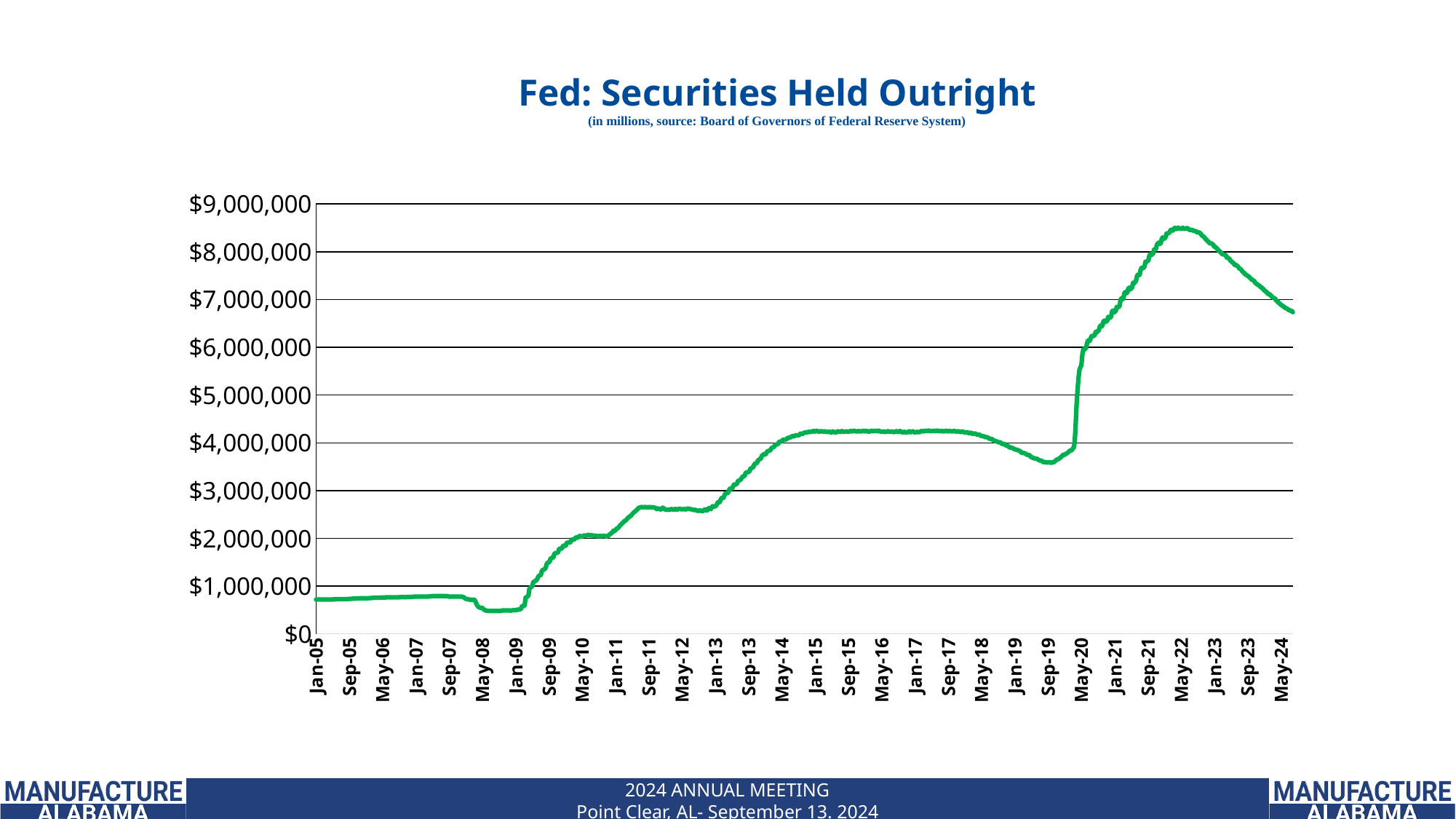
Is the value at Jan-15 greater or less than $4,000,000? greater Is the value at Sep-19 greater or less than $4,000,000? less According to the subtitle, what is the source of the data? Board of Governors of Federal Reserve System What is the title of the chart? Fed: Securities Held Outright How many lines are plotted on the chart? 1 Around which x-axis date does the line reach its highest point? May-22 Does the line rise or fall between May-22 and May-24? Fall Is the value at May-24 greater or less than $6,000,000? greater Which is larger, the value at Jan-15 or the value at Sep-19? Jan-15 What kind of chart is shown on the slide? Line chart